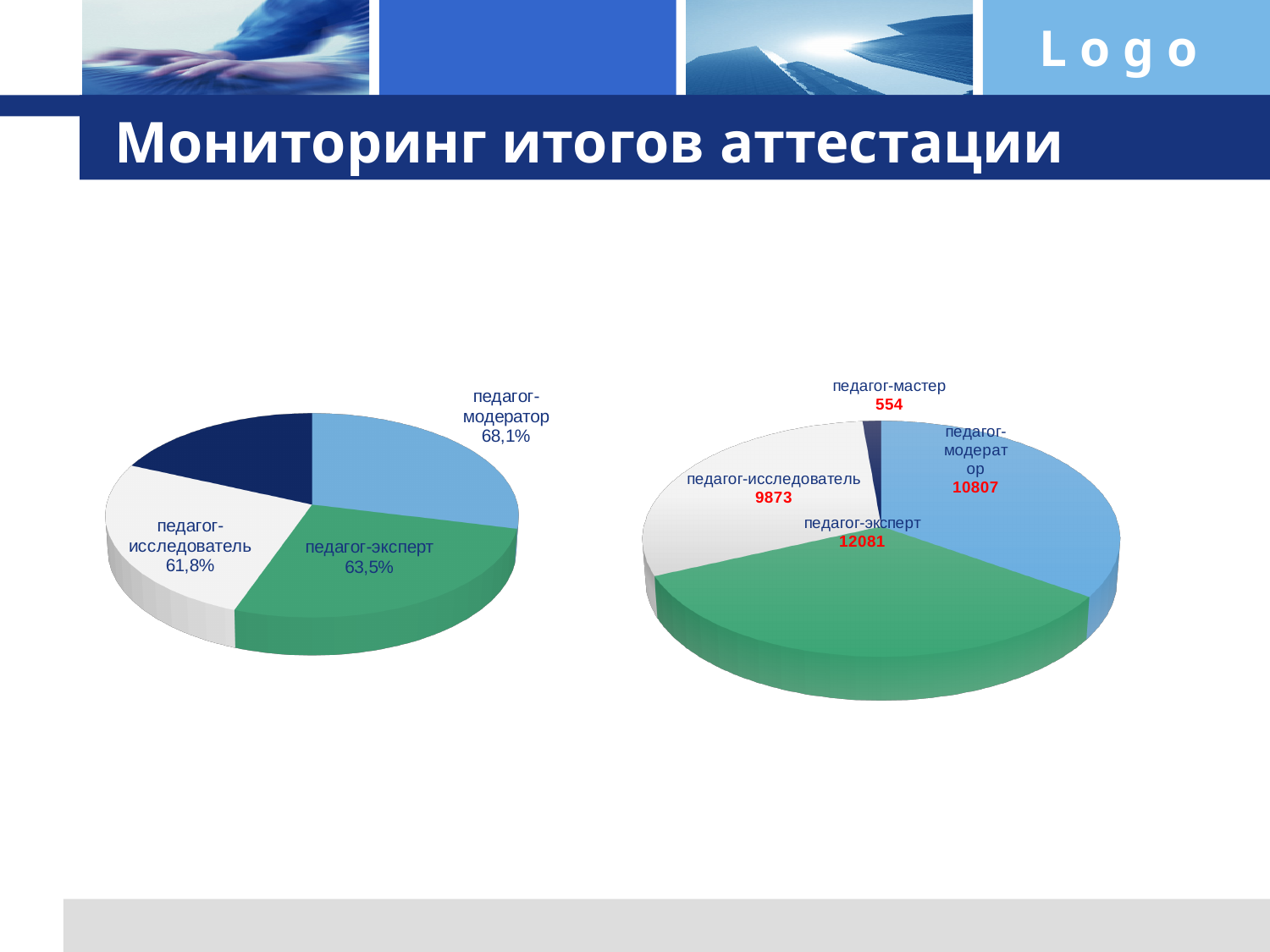
In the left pie chart, which has the larger labelled value, педагог-эксперт or педагог-исследователь? педагог-эксперт How many slices does the right pie chart have? 4 What kind of chart is the chart on the left of the slide? pie chart What is the title of the slide containing the two pie charts? Мониторинг итогов аттестации In the left pie chart, what value is shown for педагог-модератор? 68,1% In the right pie chart, which category has the lowest value? педагог-мастер In the right pie chart, which category has the highest value? педагог-эксперт In the left pie chart, what value is shown for педагог-исследователь? 61,8% In the right pie chart, what is the difference between the values for педагог-модератор and педагог-исследователь? 934 In the right pie chart, which is larger, педагог-модератор or педагог-исследователь? педагог-модератор In the right pie chart, what is the value for педагог-мастер? 554 In the right pie chart, what is the value for педагог-эксперт? 12081